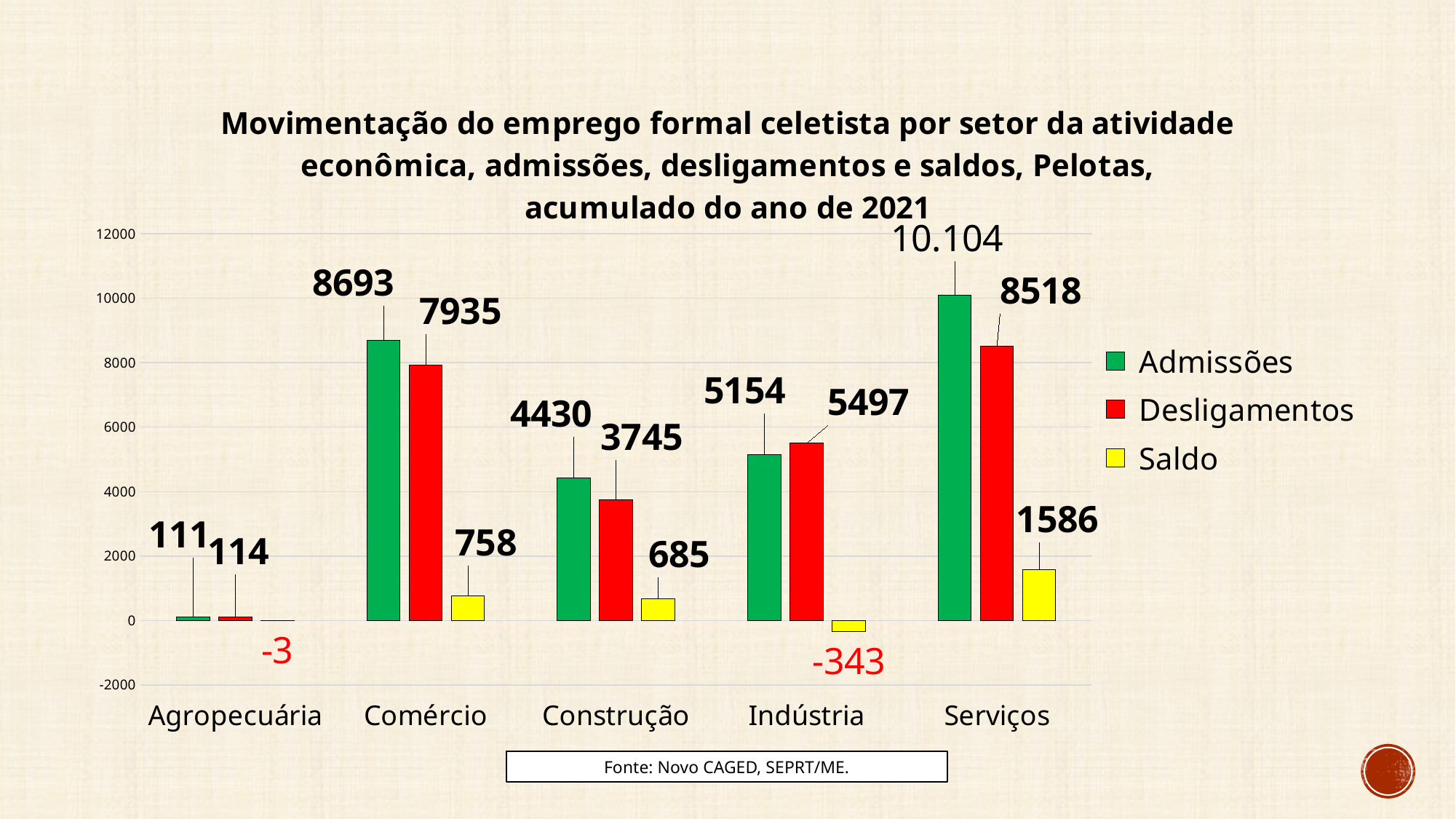
How many series does the legend list? 3 Which sector has the lowest Saldo value? Indústria What is the Saldo value for Agropecuária? -3 What is the Admissões value for Comércio? 8693 Which sector has the highest Admissões value? Serviços What is the Desligamentos value for Indústria? 5497 Which is larger for Indústria, Admissões or Desligamentos? Desligamentos What kind of chart is shown on the slide? Bar chart What is the difference between Admissões and Desligamentos for Comércio? 758 Is the Desligamentos value for Serviços greater or less than 8000? greater How many sectors are shown on the x axis? 5 What is the Saldo value for Serviços? 1586